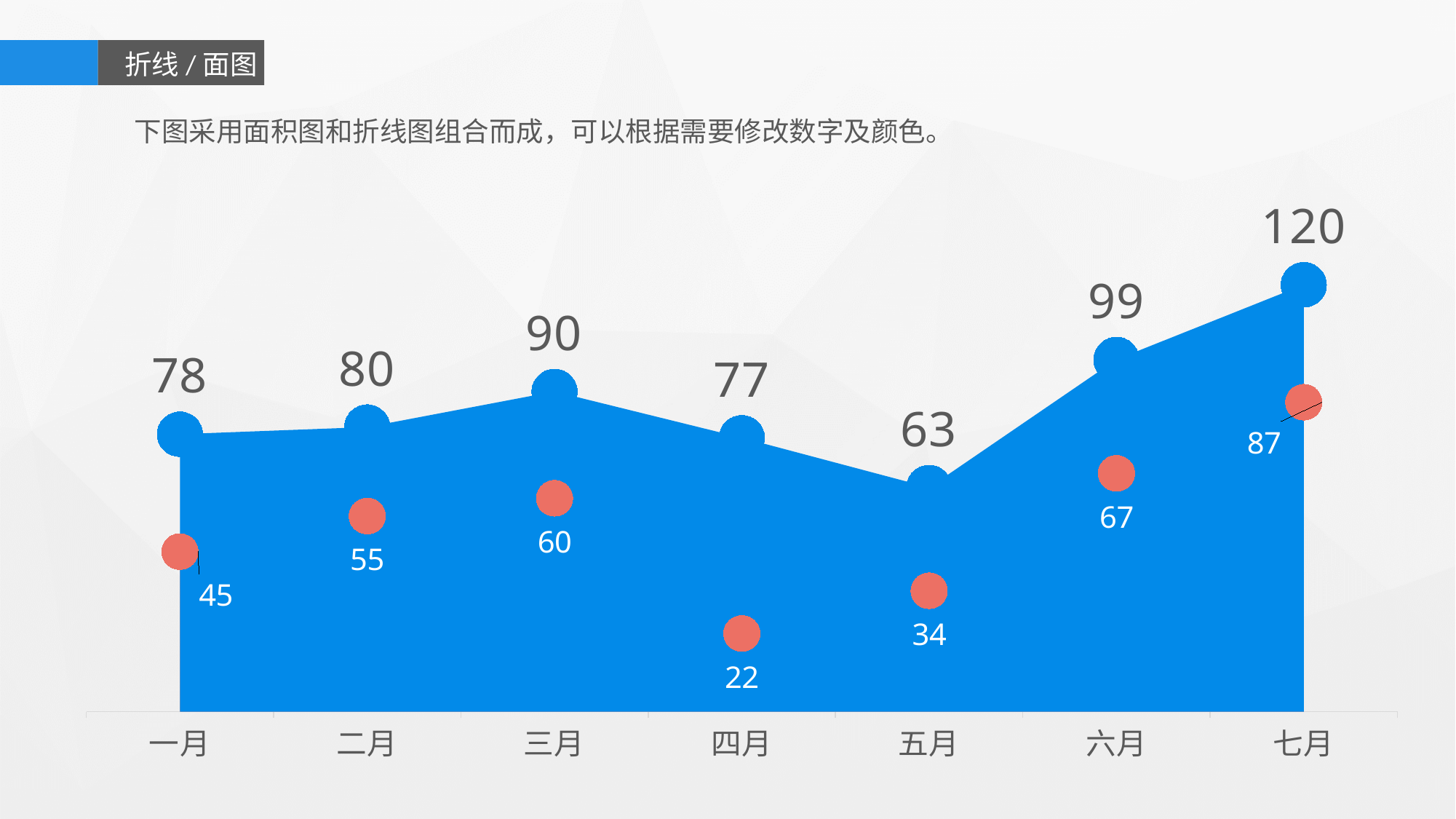
How many months are shown on the x axis? 7 What kind of chart is shown on the slide? Area chart combined with a line chart What is the difference between the blue area value and the red dot value for 六月? 32 What is the value of the blue area series for 三月? 90 Which month has the highest value in the blue area series? 七月 Which month has the lowest value in the blue area series? 五月 What is the value of the red dot series for 四月? 22 Which is larger, the red dot value for 二月 or the red dot value for 五月? 二月 What is the value of the blue area series for 七月? 120 Which month has the lowest value in the red dot series? 四月 Do the blue area values rise or fall from 五月 to 七月? Rise What is the difference between the blue area values for 七月 and 一月? 42